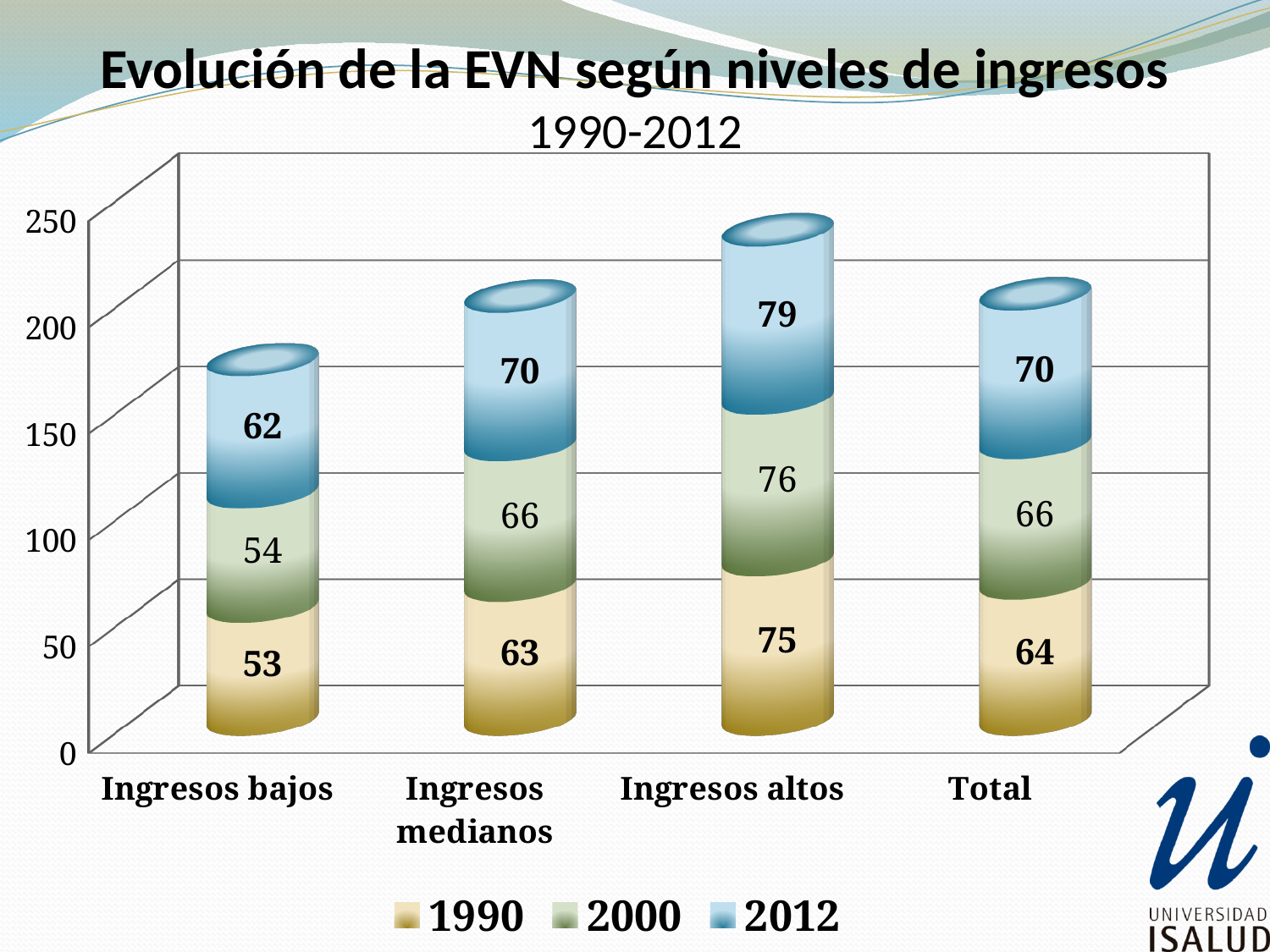
What is the difference between the 2012 and 1990 values for Ingresos bajos? 9 Which category has the lowest 1990 value? Ingresos bajos Which category has the highest 2012 value? Ingresos altos Which is larger, the 2000 value for Ingresos altos or the 2000 value for Total? Ingresos altos What is the title of the chart? Evolución de la EVN según niveles de ingresos 1990-2012 How many categories are shown on the x axis? 4 What is the 2000 value for Ingresos medianos? 66 What kind of chart is shown on the slide? Stacked bar chart What is the 1990 value for Ingresos bajos? 53 What is the total of the stacked bar for Ingresos altos? 230 What is the 2012 value for Ingresos altos? 79 How many series does the legend list? 3